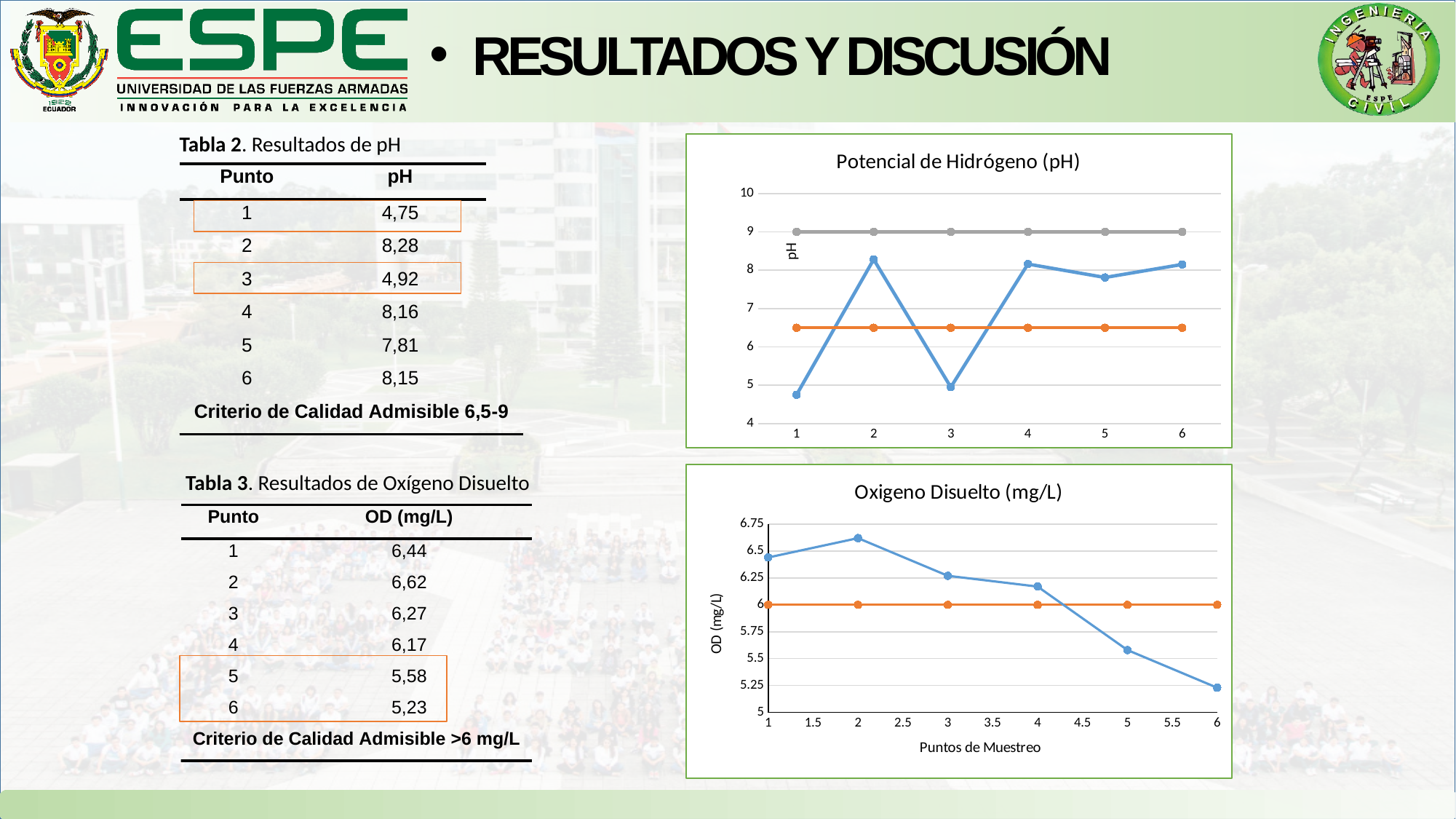
In the 'Potencial de Hidrógeno (pH)' chart, is the pH value at point 1 greater or less than 5? less In the 'Potencial de Hidrógeno (pH)' chart, is the pH value at point 2 greater or less than 8? greater What type of chart is the 'Potencial de Hidrógeno (pH)' chart? line chart In the 'Potencial de Hidrógeno (pH)' chart, how many sampling points are plotted on the x axis? 6 What is the x-axis label of the 'Oxigeno Disuelto (mg/L)' chart? Puntos de Muestreo What type of chart is the 'Oxigeno Disuelto (mg/L)' chart? line chart In the 'Potencial de Hidrógeno (pH)' chart, at what pH value is the flat gray line drawn? 9 In the 'Oxigeno Disuelto (mg/L)' chart, which sampling point has the highest dissolved oxygen value? 2 In the 'Oxigeno Disuelto (mg/L)' chart, is the value at point 5 greater or less than 5.75? less In the 'Potencial de Hidrógeno (pH)' chart, which is larger, the pH at point 2 or the pH at point 3? point 2 In the 'Oxigeno Disuelto (mg/L)' chart, do the blue line values generally rise or fall from point 2 to point 6? fall In the 'Oxigeno Disuelto (mg/L)' chart, which sampling point has the lowest dissolved oxygen value? 6